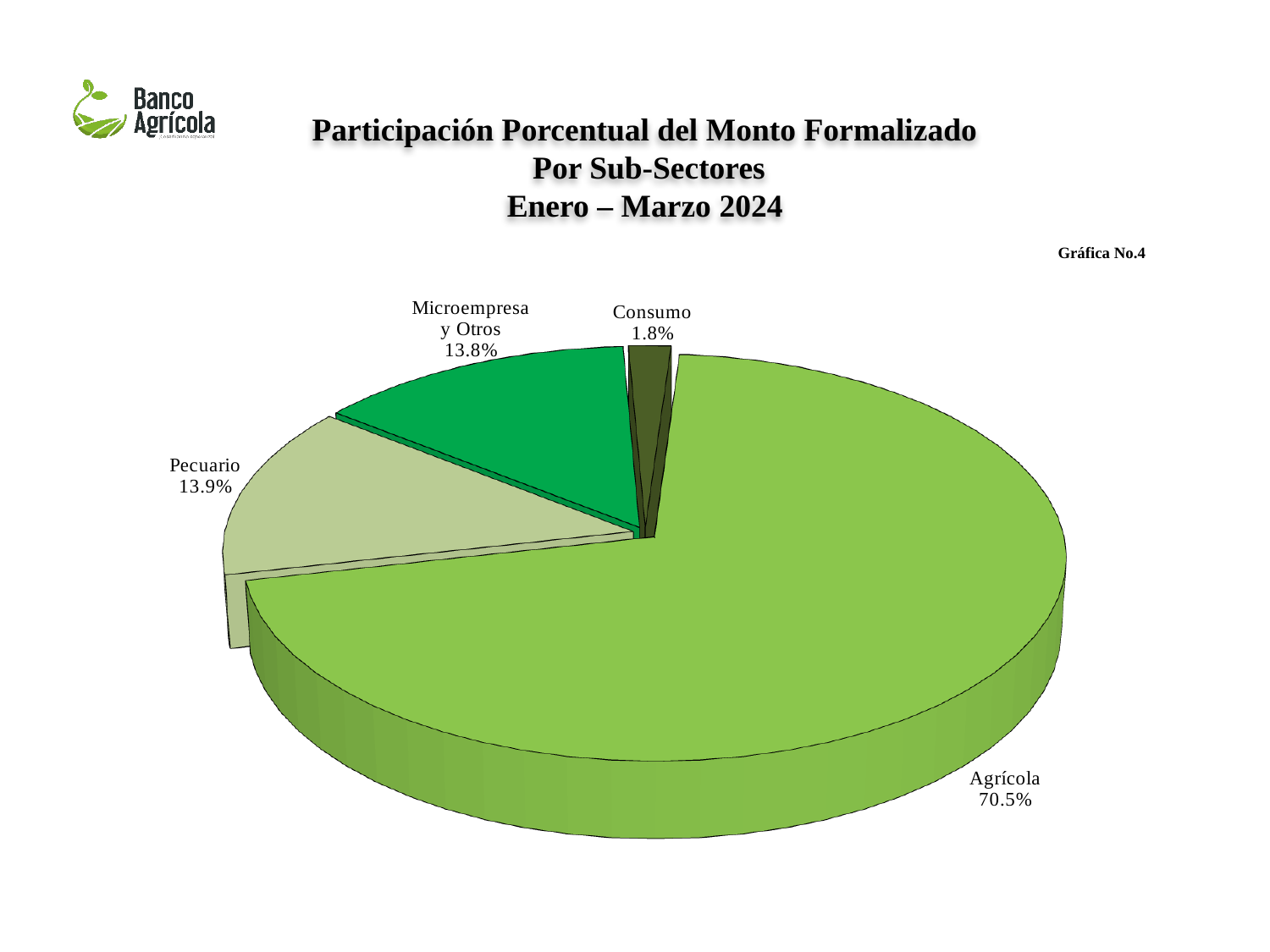
By how many percentage points does Agrícola exceed Pecuario? 56.6% What period does the chart title say the data covers? Enero – Marzo 2024 What type of chart is shown on the slide? Pie chart What is the difference between the Pecuario and Microempresa y Otros shares? 0.1% What percentage is labelled for Microempresa y Otros? 13.8% Which is larger, the share for Agrícola or the share for Consumo? Agrícola What share of the pie does Consumo represent? 1.8% Which sub-sector has the smallest share of the pie? Consumo Which sub-sector has the largest share of the formalized amount? Agrícola What is the percentage shown for Pecuario? 13.9% What percentage share does the Agrícola slice have in the pie chart? 70.5% How many sub-sectors (slices) are shown in the pie chart? 4